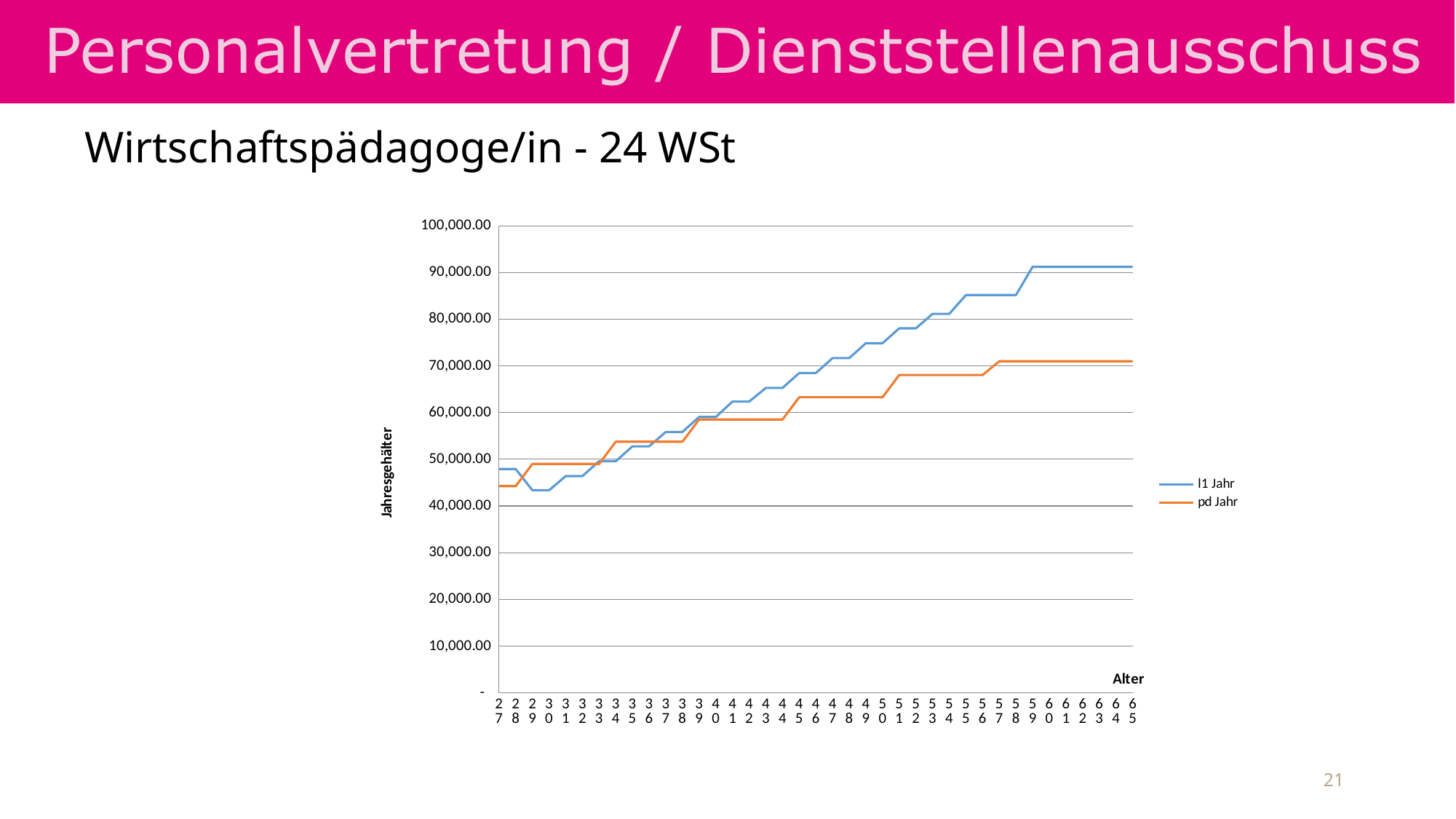
At age 65, which series has the higher value, l1 Jahr or pd Jahr? l1 Jahr Is the value for l1 Jahr at age 29 greater or less than 50,000.00? less Is the value for pd Jahr at age 65 greater or less than 80,000.00? less Which series reaches the highest value on the chart? l1 Jahr Do the values of the l1 Jahr series rise or fall as age increases along the x axis? rise At age 29, which series has the higher value, l1 Jahr or pd Jahr? pd Jahr How many age values are plotted along the x axis (from 27 to 65)? 39 How many series does the legend list? 2 Which two series are listed in the legend? l1 Jahr and pd Jahr Is the value for l1 Jahr at age 65 greater or less than 80,000.00? greater What kind of chart is shown on the slide? line chart What is the label of the vertical axis? Jahresgehälter